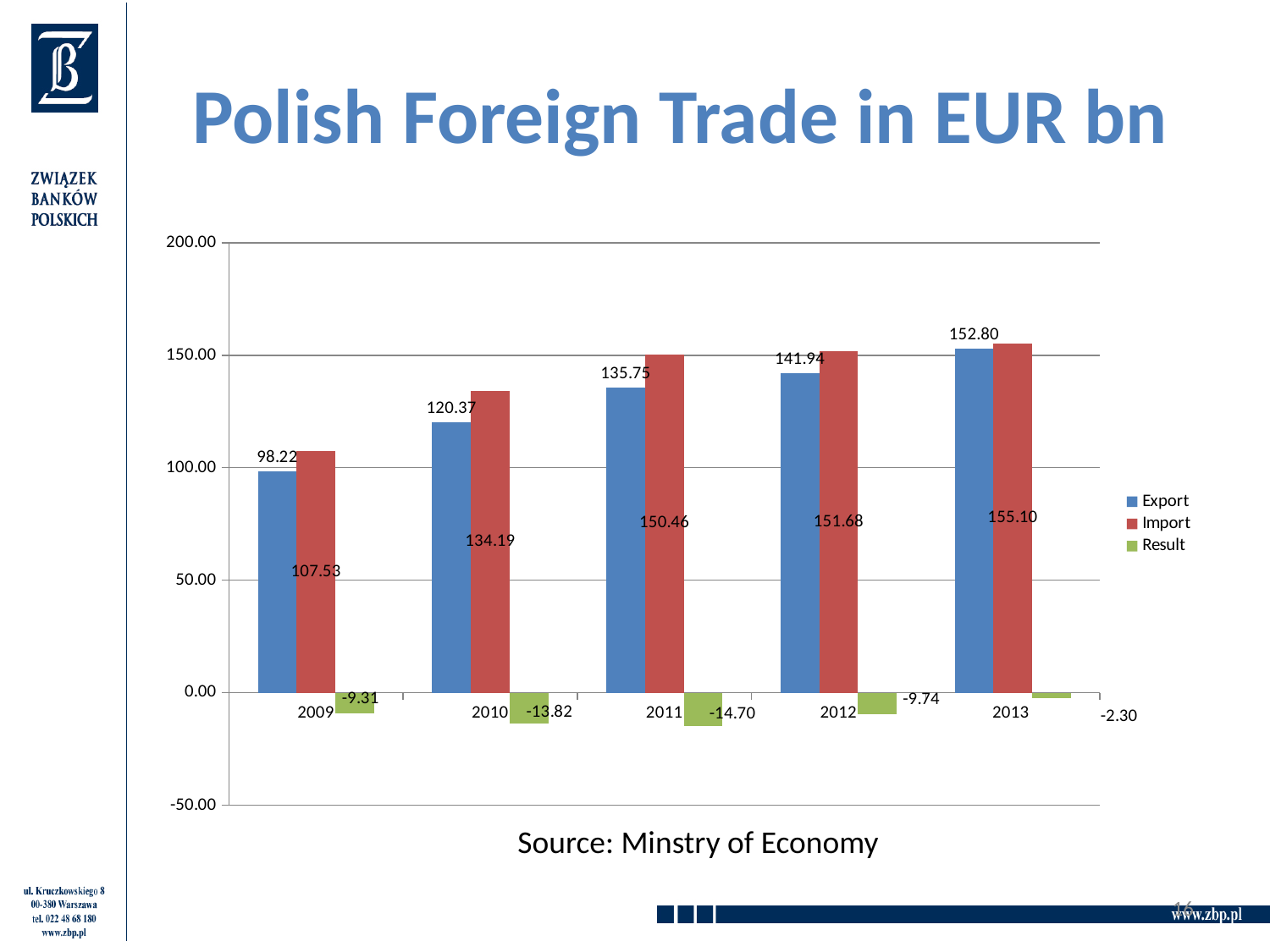
How many series does the legend list? 3 What is the Export value for 2011? 135.75 What is the Result value for 2013? -2.30 How many years are shown on the x axis? 5 What is the difference between Import and Export in 2012? 9.74 Which year has the lowest Import value? 2009 What is the Import value for 2010? 134.19 Do the Export values rise or fall from 2009 to 2013? Rise What is the title of the chart? Polish Foreign Trade in EUR bn Which is larger in 2009, Export or Import? Import Which year has the highest Export value? 2013 What kind of chart is shown on the slide? Bar chart